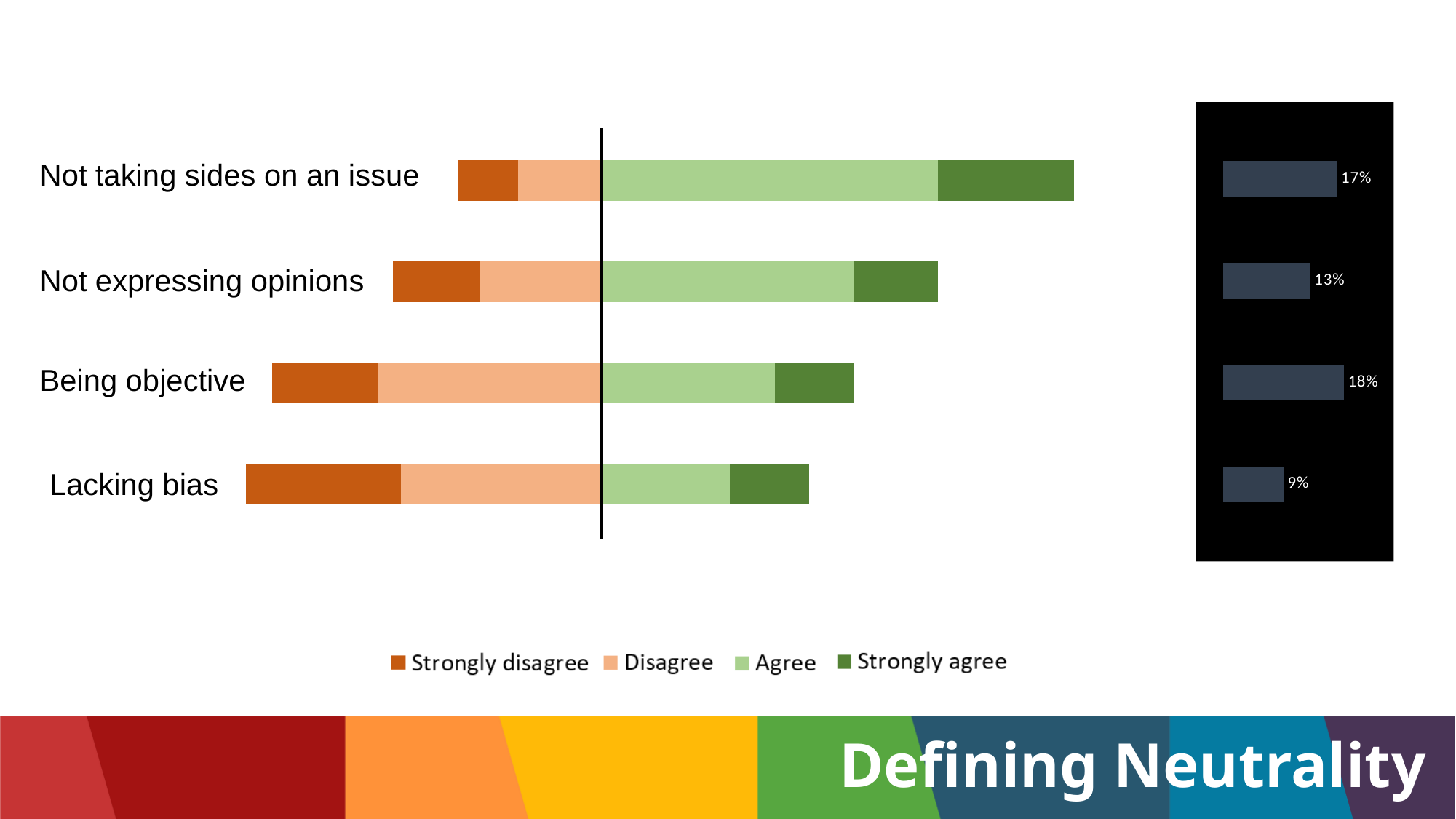
In the chart on the right with the black background, what is the value of the bottom bar? 9% In the main chart, which series is shown in dark green? Strongly agree In the main chart, which category has the largest Agree segment? Not taking sides on an issue In the main chart, which category has the largest Strongly disagree segment? Lacking bias How many categories does the main chart on the left show? 4 In the chart on the right with the black background, what is the difference between the highest and lowest values? 9 percentage points In the chart on the right with the black background, what is the highest value shown? 18% In the chart on the right with the black background, what is the value of the top bar? 17% How many series does the legend of the main chart list? 4 In the chart on the right with the black background, is the top bar or the second bar larger? The top bar (17%) What kind of chart is the main chart on the left of the slide? Stacked bar chart